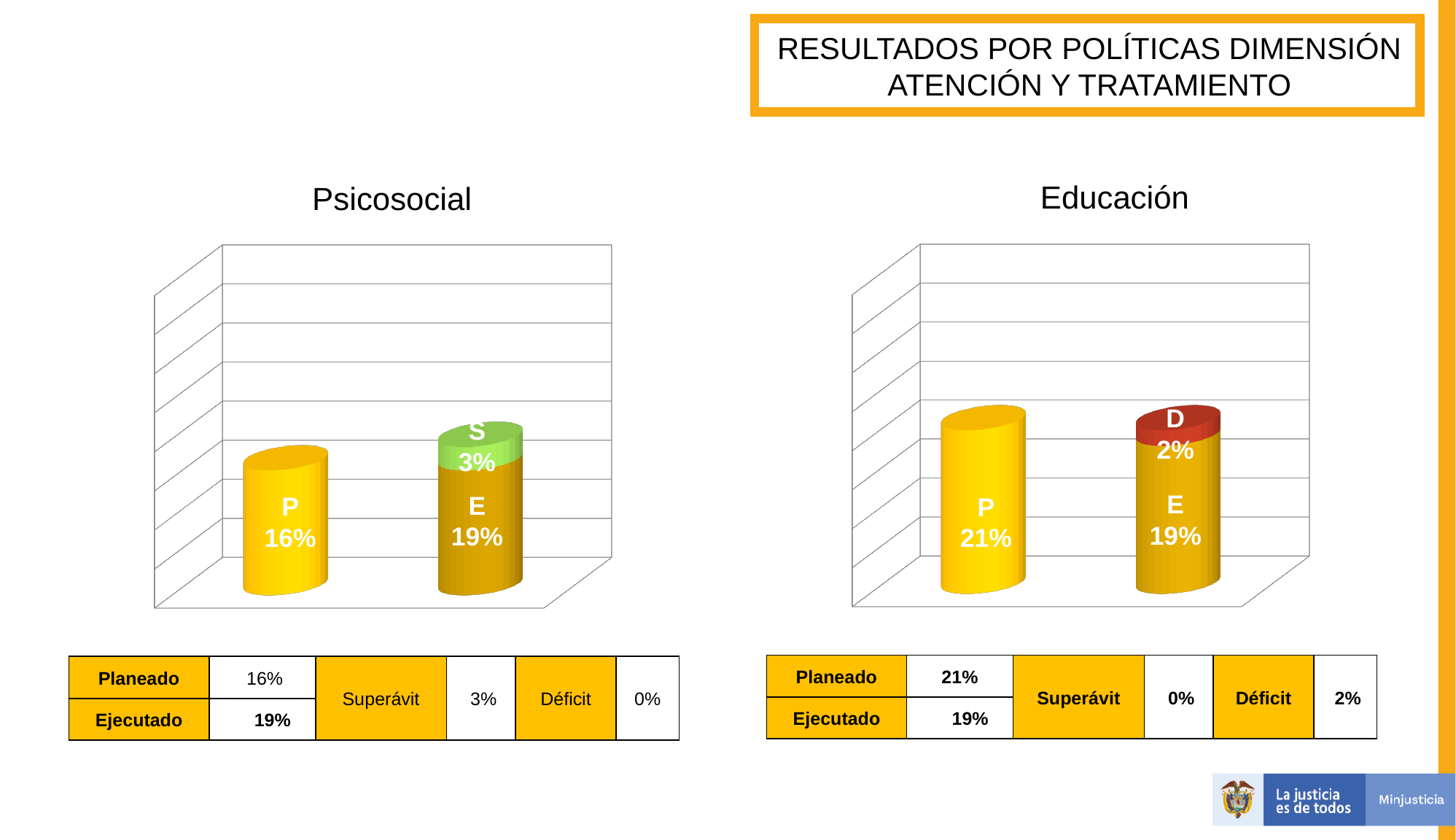
In the Psicosocial chart, what is the difference between E (19%) and P (16%)? 3% In the Psicosocial chart, what is the value labelled P? 16% In the Educación chart, what value is shown for the red segment labelled D? 2% In the Educación chart, what is the difference between P (21%) and E (19%)? 2% In the Psicosocial chart, what value is shown for the green segment labelled S? 3% In the Psicosocial chart, which is larger, P or E? E What colour is the segment labelled D in the Educación chart? Red In the Psicosocial chart, what is the value labelled E? 19% In the Educación chart, which is larger, P or E? P How many bars are plotted in the Educación chart? 2 What kind of chart is the Psicosocial chart? Bar chart In the Educación chart, what is the value labelled P? 21%